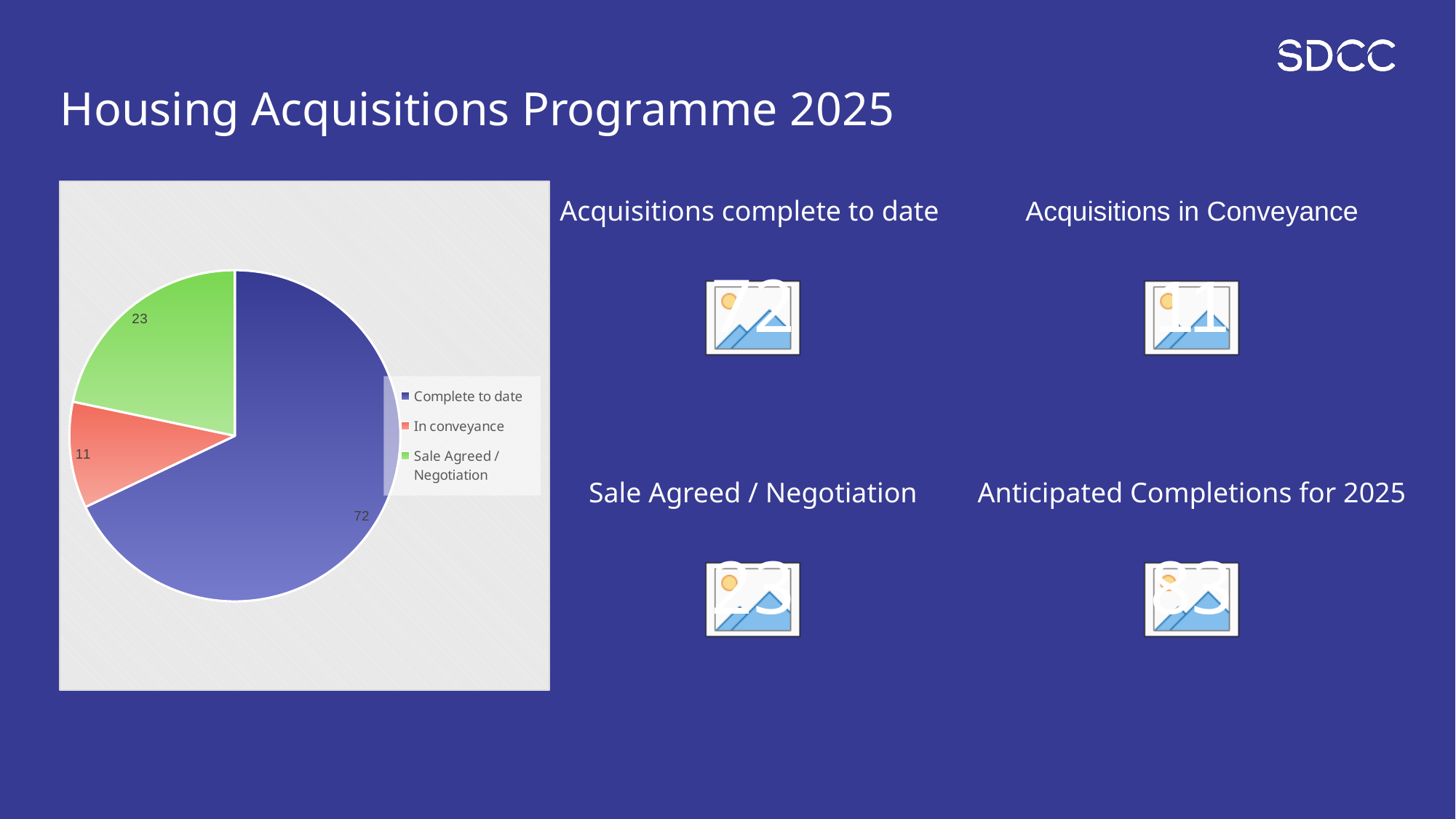
What is the total of all the values shown in the pie chart? 106 What is the value for In conveyance in the pie chart? 11 Which category has the smallest slice in the pie chart? In conveyance What is the difference between the Complete to date value and the Sale Agreed / Negotiation value? 49 Which is larger, the In conveyance slice or the Sale Agreed / Negotiation slice? Sale Agreed / Negotiation What is the value for Complete to date in the pie chart? 72 What is the value for Sale Agreed / Negotiation in the pie chart? 23 What type of chart is shown on the slide? Pie chart Which category has the largest slice in the pie chart? Complete to date What colour is the Complete to date slice in the pie chart? Blue How many slices does the pie chart have? 3 What is the difference between the Sale Agreed / Negotiation value and the In conveyance value? 12